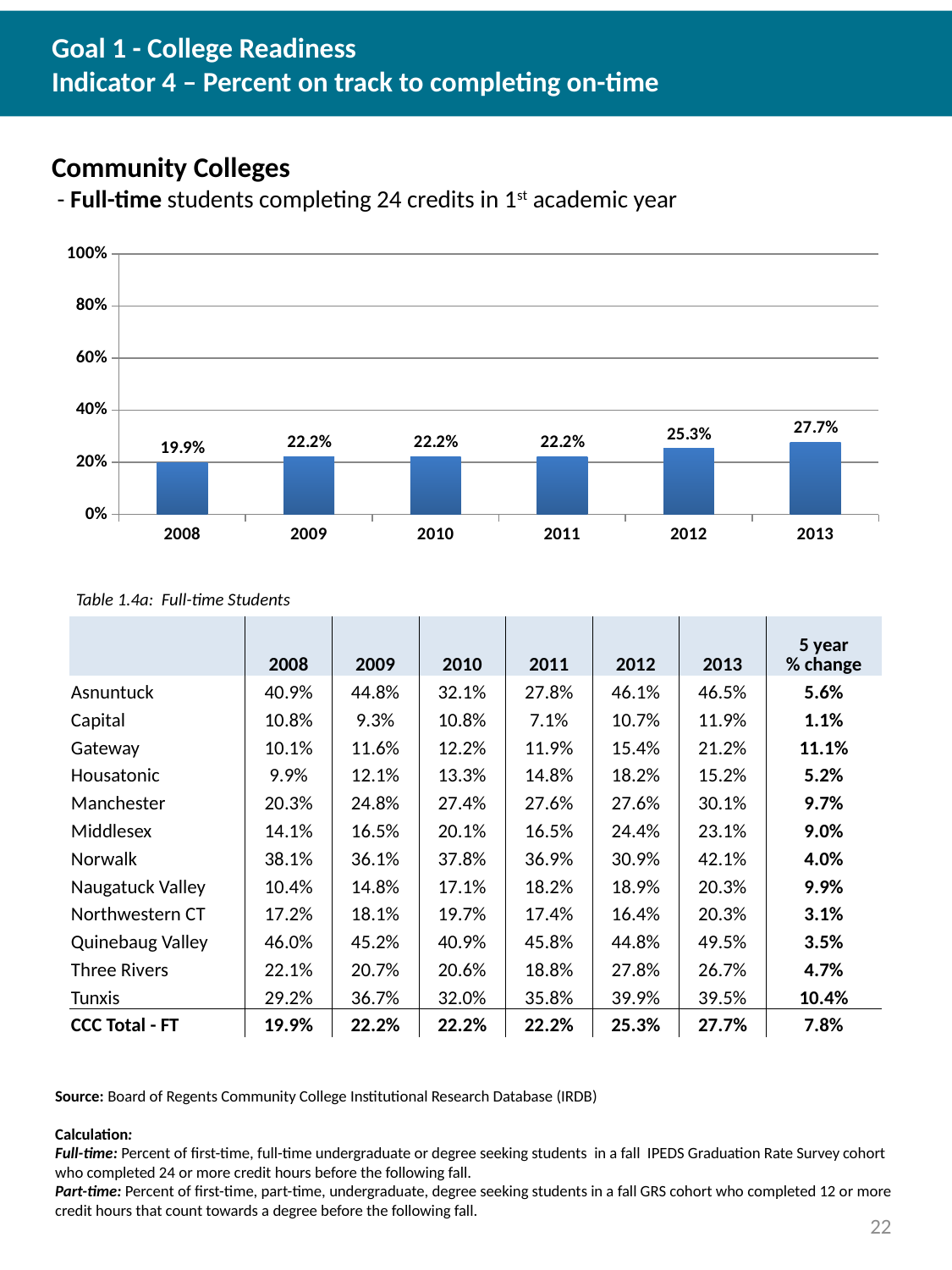
What is the value for 2012 in the bar chart? 25.3% Which year has the highest value in the bar chart? 2013 What is the value for 2013 in the bar chart? 27.7% Which is larger in the bar chart, the value for 2012 or the value for 2009? 2012 Do the values in the bar chart generally rise or fall from 2008 to 2013? rise Is the value for 2013 in the bar chart greater or less than 40%? less What is the difference between the 2013 and 2008 values in the bar chart? 7.8% What is the difference between the 2013 and 2012 values in the bar chart? 2.4% Which year has the lowest value in the bar chart? 2008 What is the value for 2008 in the bar chart? 19.9% What kind of chart is shown on the slide? bar chart How many years are shown on the x axis of the bar chart? 6